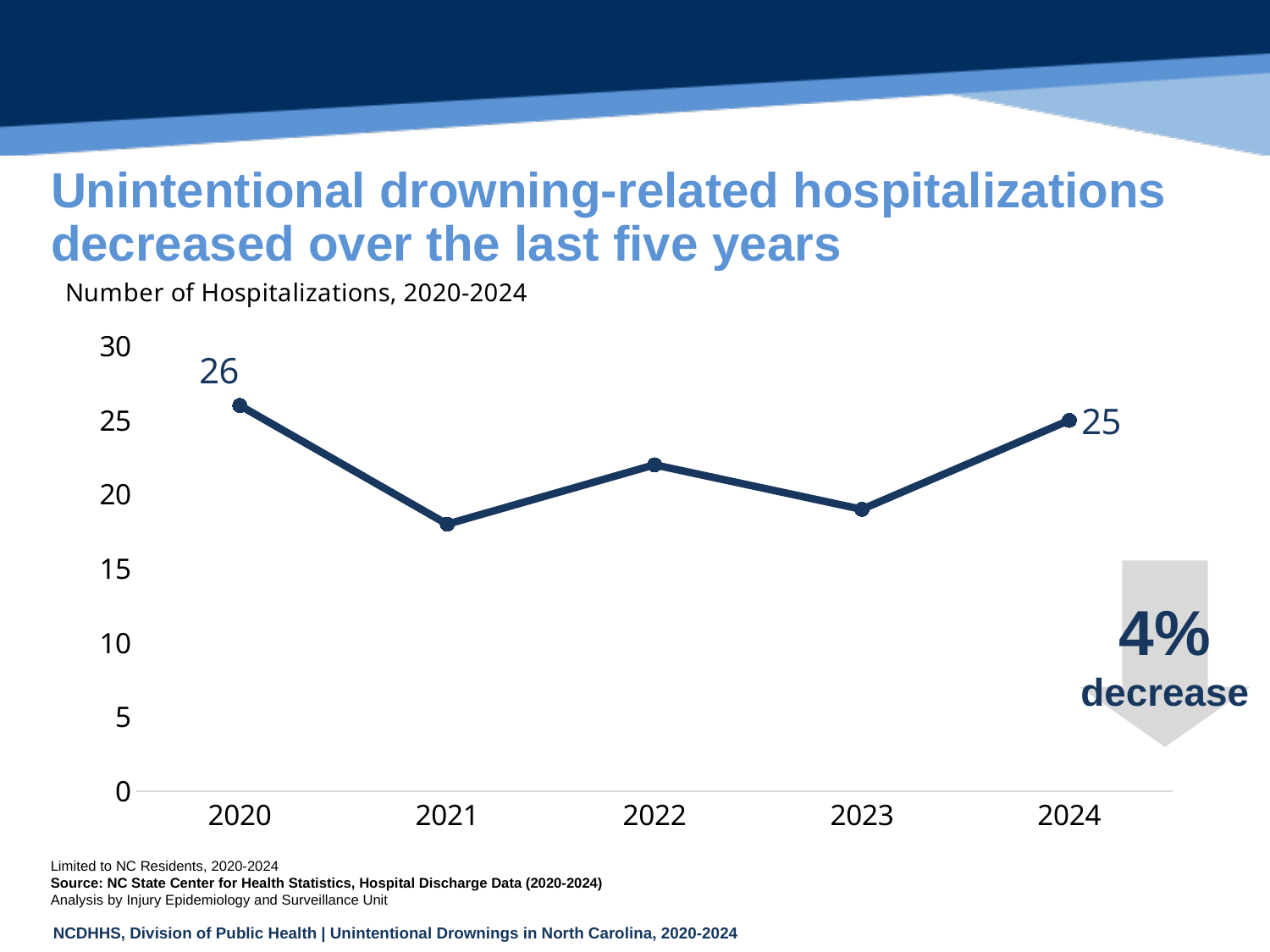
Is the value for 2023 greater or less than 20? less What is the difference between the number of hospitalizations in 2020 and in 2024? 1 What percentage decrease is highlighted next to the chart? 4% Is the value for 2022 greater or less than 20? greater What is the number of hospitalizations in 2024? 25 What is the number of hospitalizations in 2020? 26 What kind of chart is shown on the slide? line chart How many years are plotted on the chart? 5 Did the number of hospitalizations rise or fall from 2020 to 2024? fall Which year has the higher number of hospitalizations, 2020 or 2024? 2020 Which year has the highest number of hospitalizations? 2020 Is the value for 2021 greater or less than 20? less